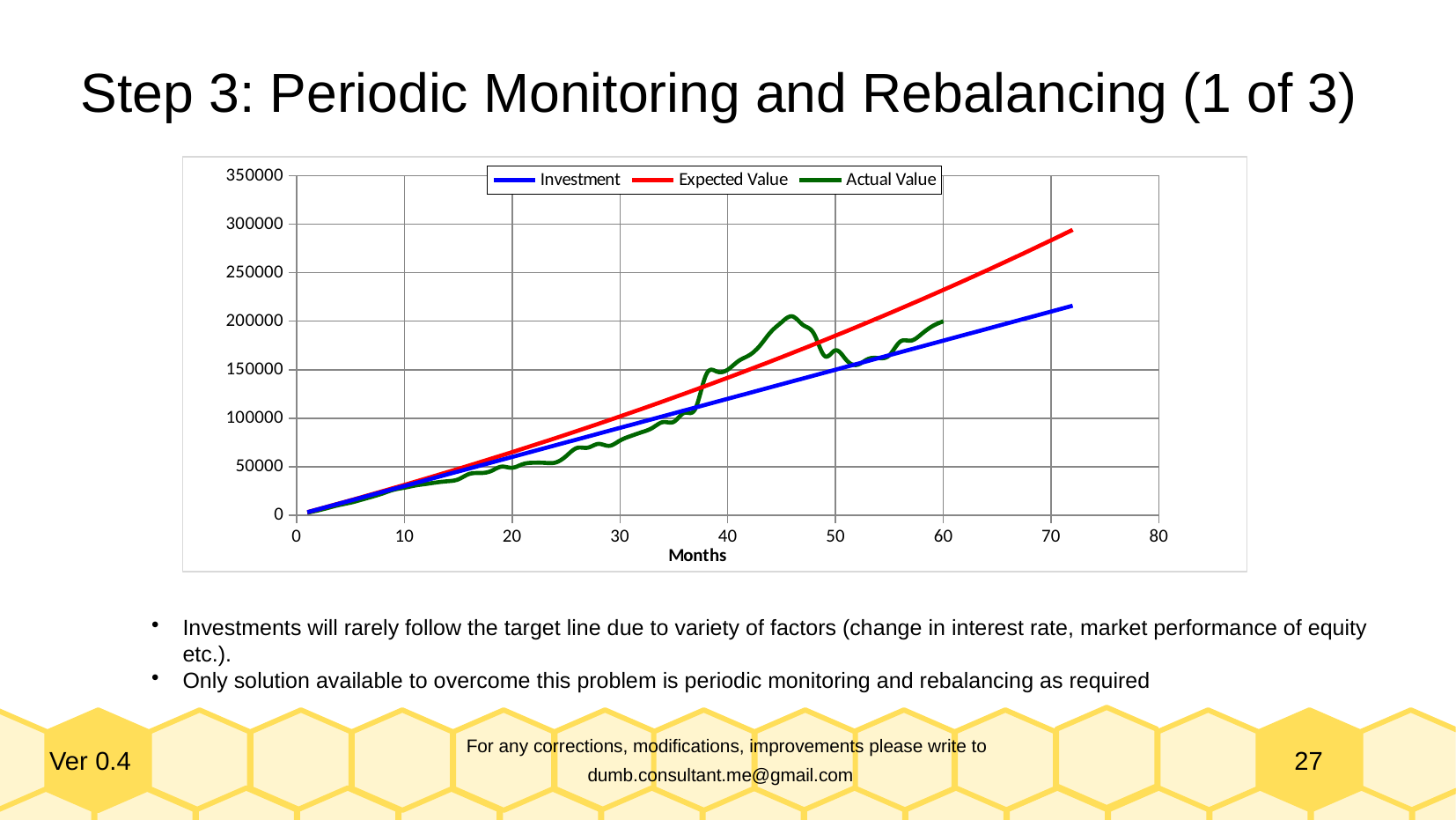
What are the three series named in the legend? Investment, Expected Value, Actual Value Is the Expected Value at month 70 greater or less than 250000? greater At month 60, which is larger: Expected Value or Investment? Expected Value How many series does the legend list? 3 Which series reaches the highest value on the chart? Expected Value What kind of chart is shown on the slide? Line chart What is the title of the x axis? Months At month 30, which is larger: Actual Value or Expected Value? Expected Value Does the Expected Value line rise or fall as months increase? Rise Is the Actual Value at month 30 greater or less than 100000? less Does the Investment line rise or fall as months increase? Rise Is the Investment value at month 60 greater or less than 150000? greater